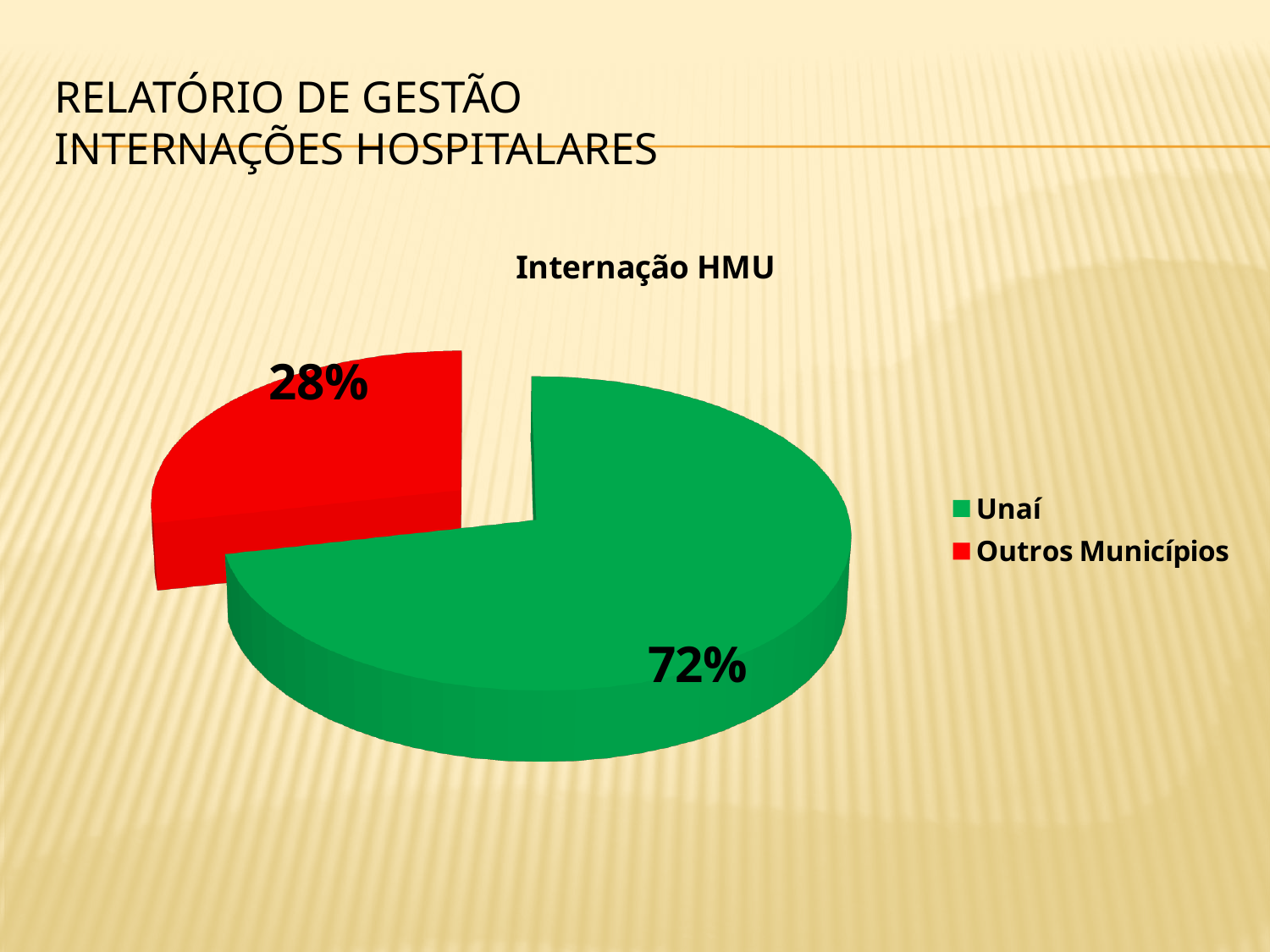
What share of the pie does Unaí account for? 72% What is the difference in percentage points between the Unaí slice and the Outros Municípios slice? 44 What colour is the Outros Municípios slice? Red Which category has the largest slice of the pie? Unaí How many entries does the legend list? 2 How many slices does the pie chart have? 2 What kind of chart is shown on the slide? Pie chart What share of the pie does Outros Municípios account for? 28% Which slice is larger, Unaí or Outros Municípios? Unaí Which category has the smallest slice of the pie? Outros Municípios What is the title of the chart? Internação HMU